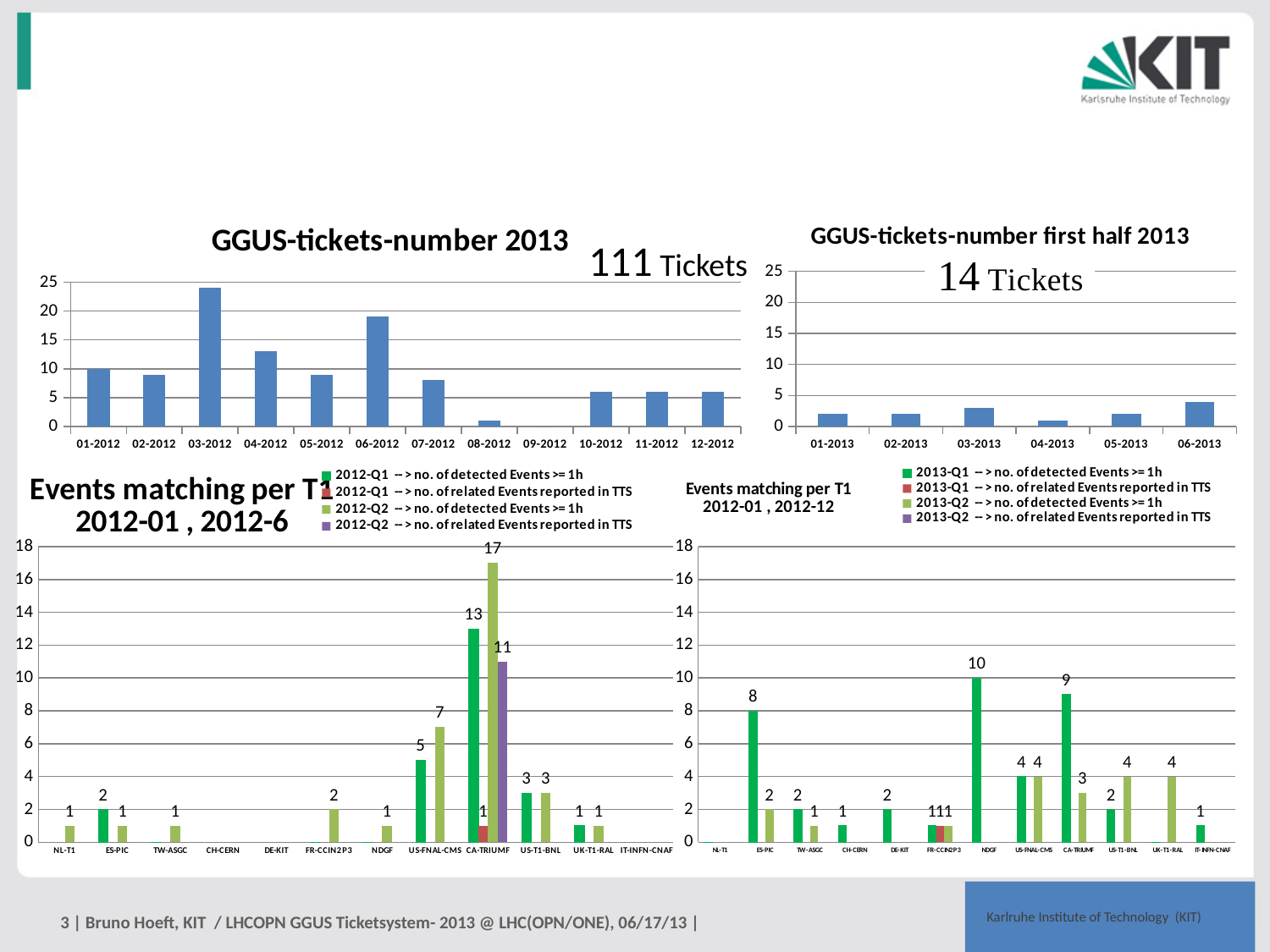
How many series does the legend of the 'Events matching per T1 2012-01, 2012-6' chart (bottom left) list? 4 In the 'Events matching per T1 2012-01, 2012-6' chart (bottom left), what is the difference between the 2012-Q2 detected events (17) and the 2012-Q1 detected events (13) for CA-TRIUMF? 4 What kind of chart is the 'GGUS-tickets-number first half 2013' chart (top right)? bar chart In the 'Events matching per T1 2012-01, 2012-6' chart (bottom left), what is the value of the 2012-Q2 no. of detected Events >= 1h series for CA-TRIUMF? 17 In the 'GGUS-tickets-number 2013' chart (top left), is the value for 06-2012 greater or less than 15? greater In the 'Events matching per T1 2012-01, 2012-12' chart (bottom right), which T1 site has the highest labelled value? NDGF In the 'Events matching per T1 2012-01, 2012-12' chart (bottom right), which is larger: the 2013-Q1 detected events for ES-PIC or for CA-TRIUMF? CA-TRIUMF In the 'GGUS-tickets-number 2013' chart (top left), is the value for 03-2012 greater or less than 20? greater How many months are shown on the x axis of the 'GGUS-tickets-number 2013' chart (top left)? 12 In the 'GGUS-tickets-number 2013' chart (top left), which month has the highest bar? 03-2012 In the 'GGUS-tickets-number first half 2013' chart (top right), is the value for 06-2013 greater or less than 5? less In the 'GGUS-tickets-number first half 2013' chart (top right), which month has the highest bar? 06-2013